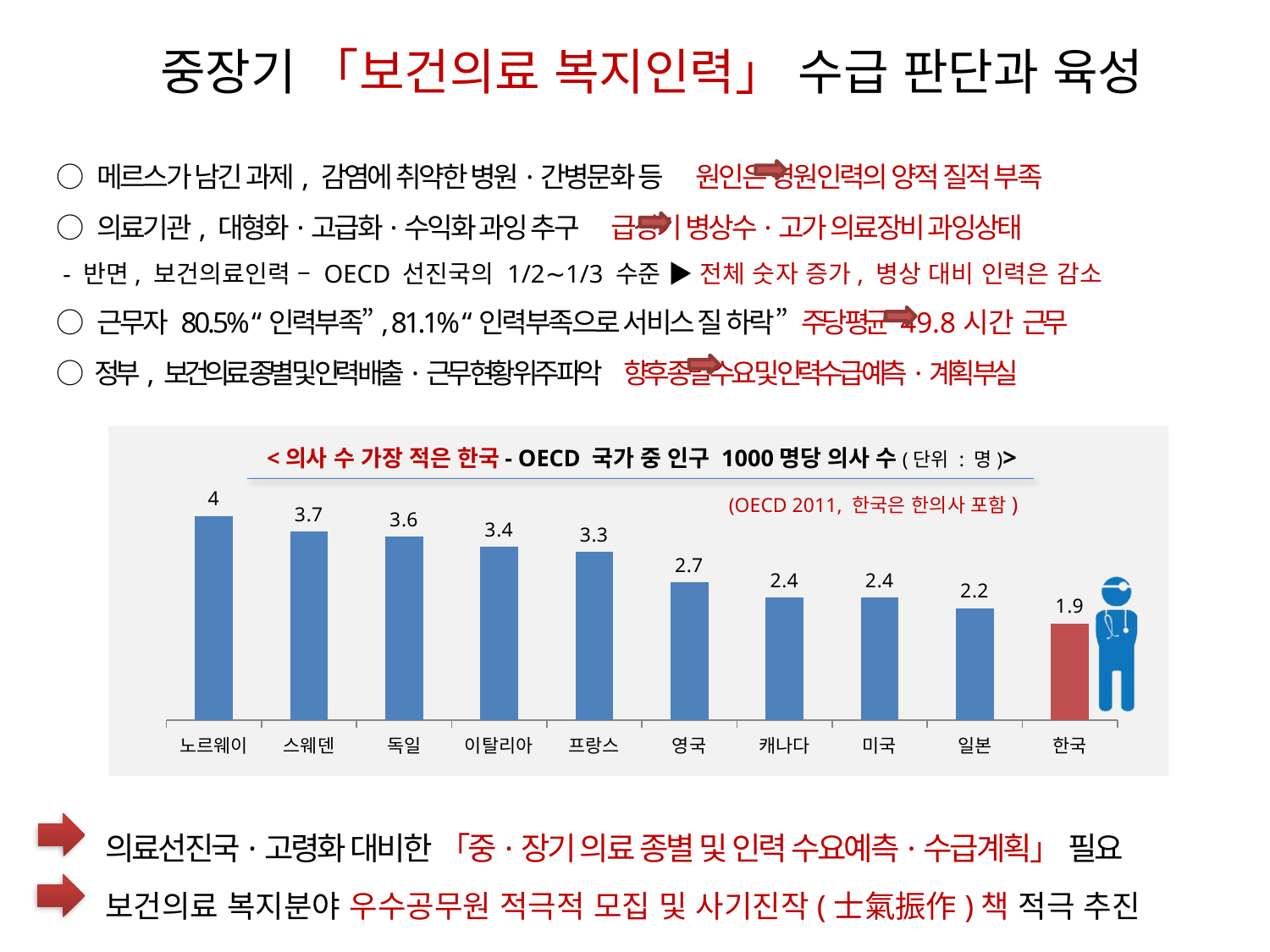
What is the value for 프랑스 in the chart? 3.3 What is the value for 한국 in the chart? 1.9 Which country has the highest value in the chart? 노르웨이 What kind of chart is shown on the slide? bar chart Which country's bar is coloured red instead of blue? 한국 What is the difference between the values for 노르웨이 and 한국? 2.1 What is the difference between the values for 스웨덴 and 영국? 1 How many countries are shown in the chart? 10 Do the values rise or fall from left to right along the x axis? fall Which has a larger value, 독일 or 일본? 독일 What is the value for 노르웨이 in the chart? 4 Which country has the lowest value in the chart? 한국